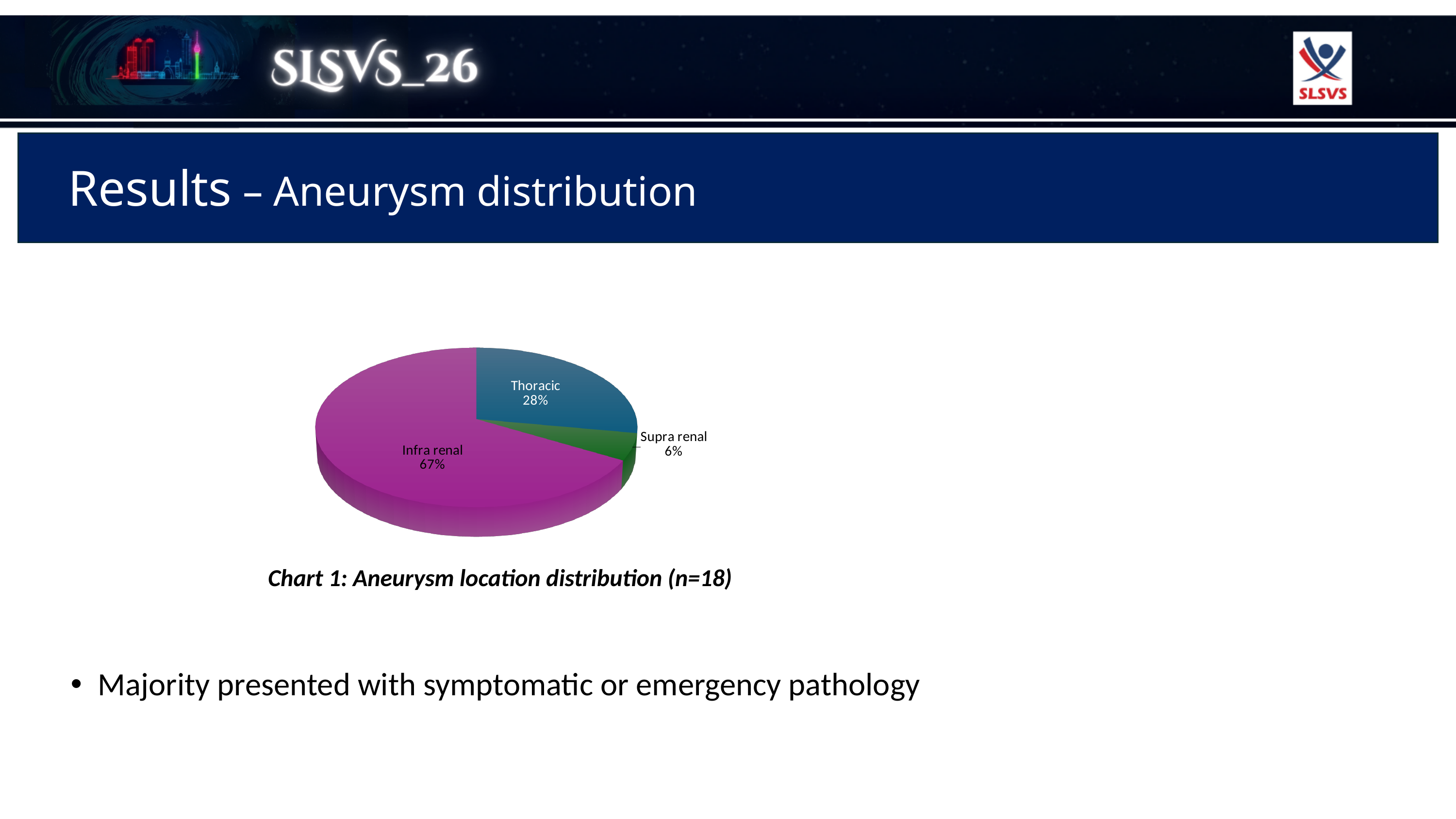
What share of the pie does Supra renal represent? 6% What kind of chart is shown on the slide? Pie chart What is the difference in percentage points between Infra renal and Thoracic? 39 Which aneurysm location has the smallest share? Supra renal How many slices does the pie chart have? 3 What is the difference in percentage points between Thoracic and Supra renal? 22 What share of the pie does Infra renal represent? 67% What share of the pie does Thoracic represent? 28% What colour is the Infra renal slice? Purple Which is larger, the Thoracic share or the Supra renal share? Thoracic What is the caption of the chart? Chart 1: Aneurysm location distribution (n=18) Which aneurysm location has the largest share? Infra renal